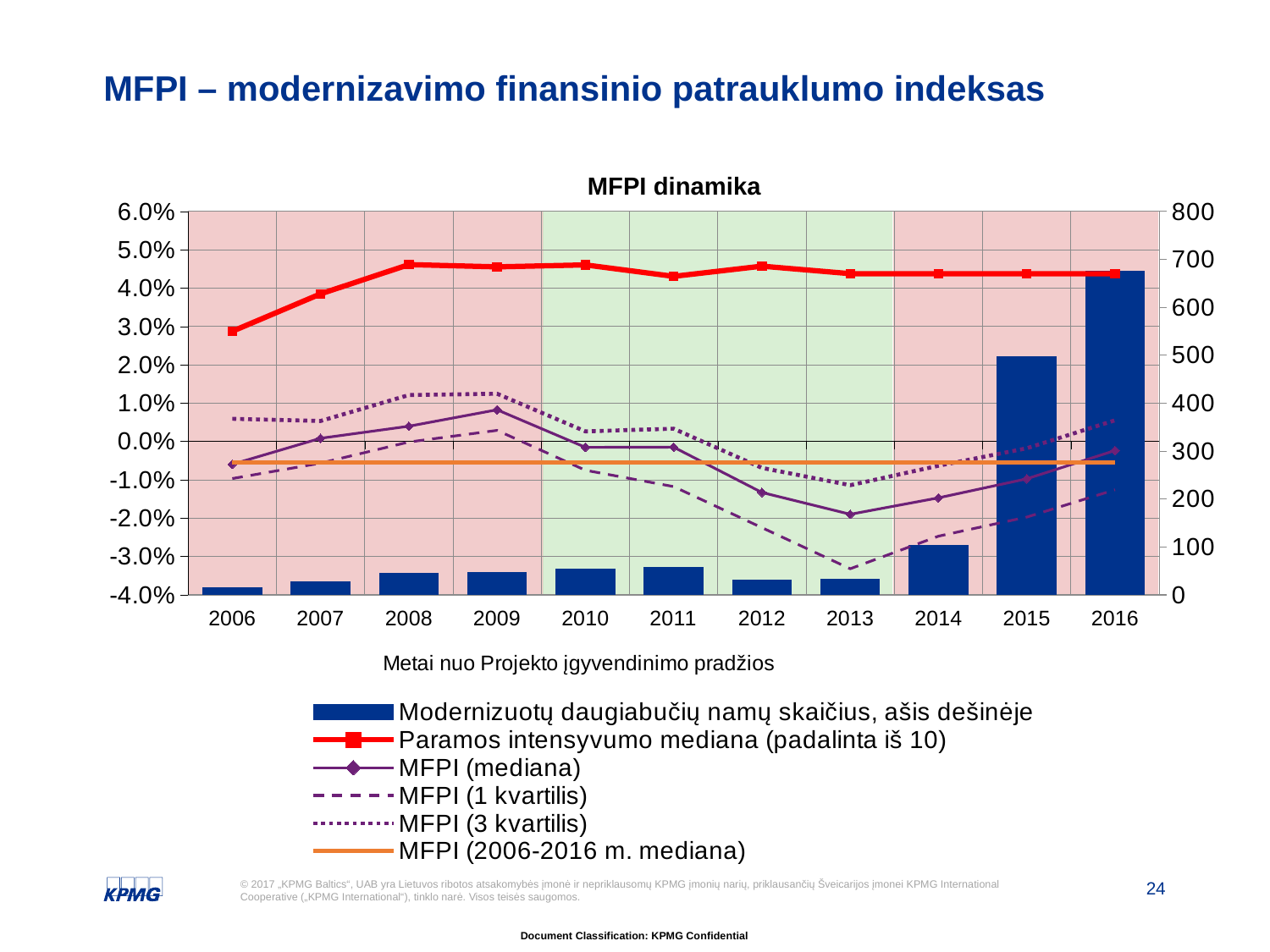
In which year is the bar for Modernizuotų daugiabučių namų skaičius the highest? 2016 Is the value of the bar for 2016 (right axis) greater or less than 600? greater What kind of chart is shown on the slide? A combined bar and line chart In which year is the bar for Modernizuotų daugiabučių namų skaičius the lowest? 2006 Is the value of the bar for 2014 (right axis) greater or less than 200? less What is the title of the chart? MFPI dinamika Is the value of Paramos intensyvumo mediana (padalinta iš 10) in 2008 greater or less than 4.0%? greater Which bar is larger, 2015 or 2016? 2016 Do the bars for Modernizuotų daugiabučių namų skaičius rise or fall from 2014 to 2016? rise How many series does the legend list? 6 In which year does the MFPI (mediana) line reach its lowest point? 2013 How many years are shown on the x axis? 11